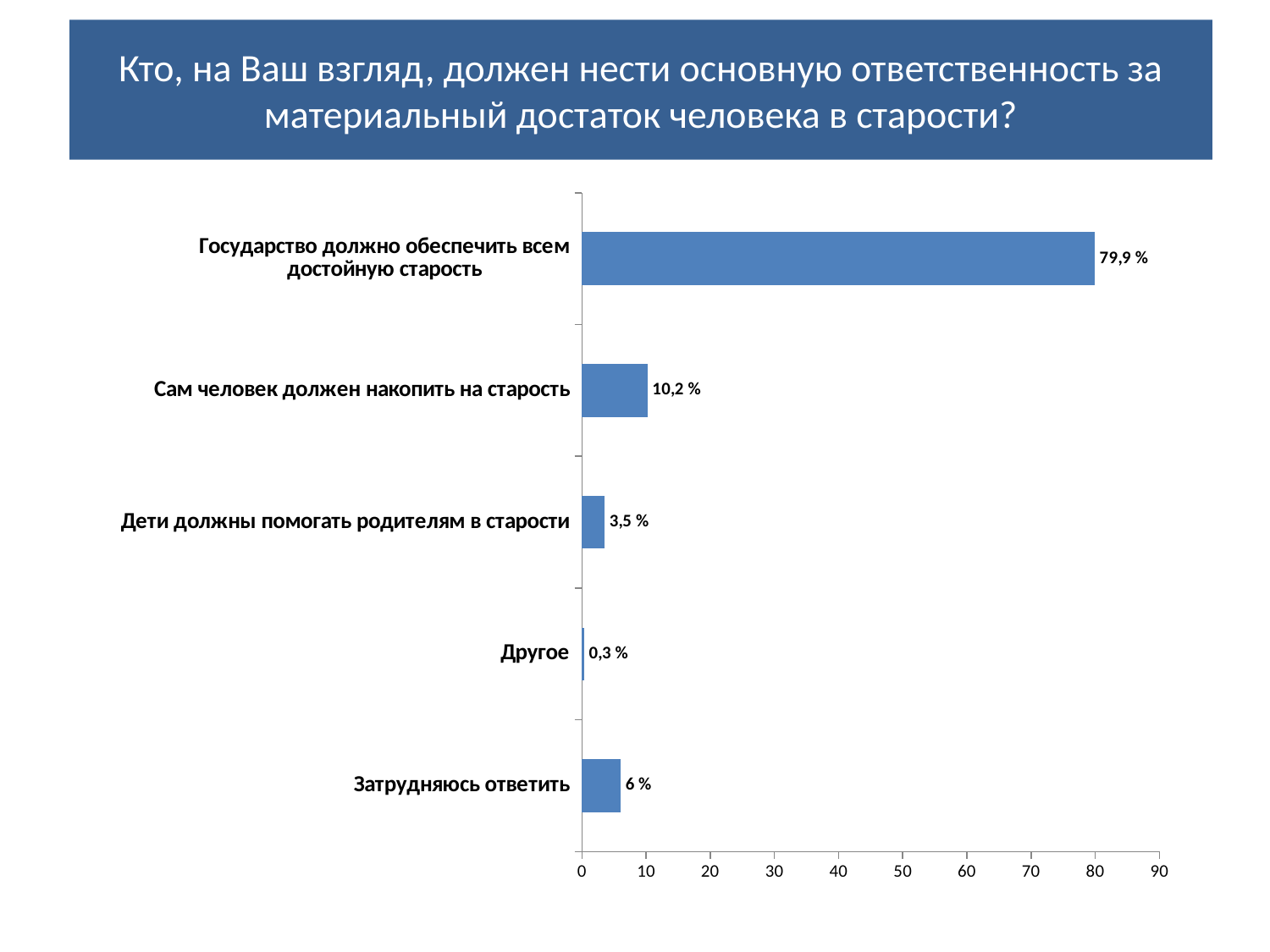
Is the value for «Сам человек должен накопить на старость» greater or less than 20? less What kind of chart is shown on the slide? bar chart Which is larger: «Затрудняюсь ответить» or «Дети должны помогать родителям в старости»? Затрудняюсь ответить Which category has the lowest value? Другое What is the value for «Сам человек должен накопить на старость»? 10,2 % What is the value for «Государство должно обеспечить всем достойную старость»? 79,9 % What is the value for «Затрудняюсь ответить»? 6 % What is the value for «Дети должны помогать родителям в старости»? 3,5 % How many categories are shown in the chart? 5 What is the difference between «Государство должно обеспечить всем достойную старость» and «Сам человек должен накопить на старость»? 69,7 % Which category has the highest value? Государство должно обеспечить всем достойную старость What is the difference between «Затрудняюсь ответить» and «Дети должны помогать родителям в старости»? 2,5 %